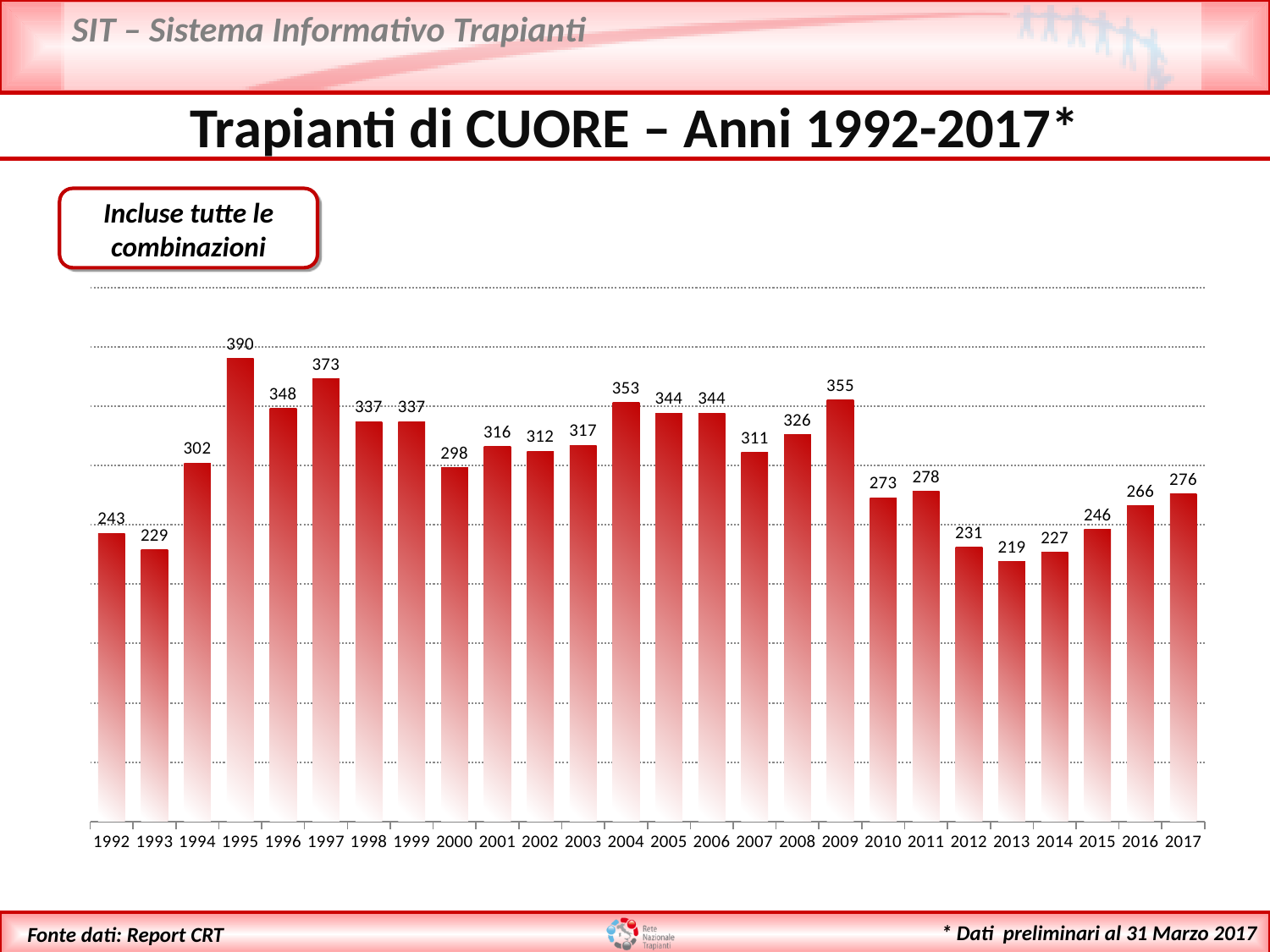
What is the value for 2017? 276 Which year has the highest value? 1995 Which year has the lowest value? 2013 Which is larger, the value for 1997 or the value for 2009? 1997 What is the difference between the values for 2009 and 2010? 82 What is the difference between the values for 1995 and 2013? 171 How many years are shown on the x axis? 26 What kind of chart is shown? bar chart Do the values rise or fall from 2013 to 2017? rise What is the value for 1995? 390 What is the value for 2013? 219 Which is larger, the value for 1992 or the value for 2015? 2015